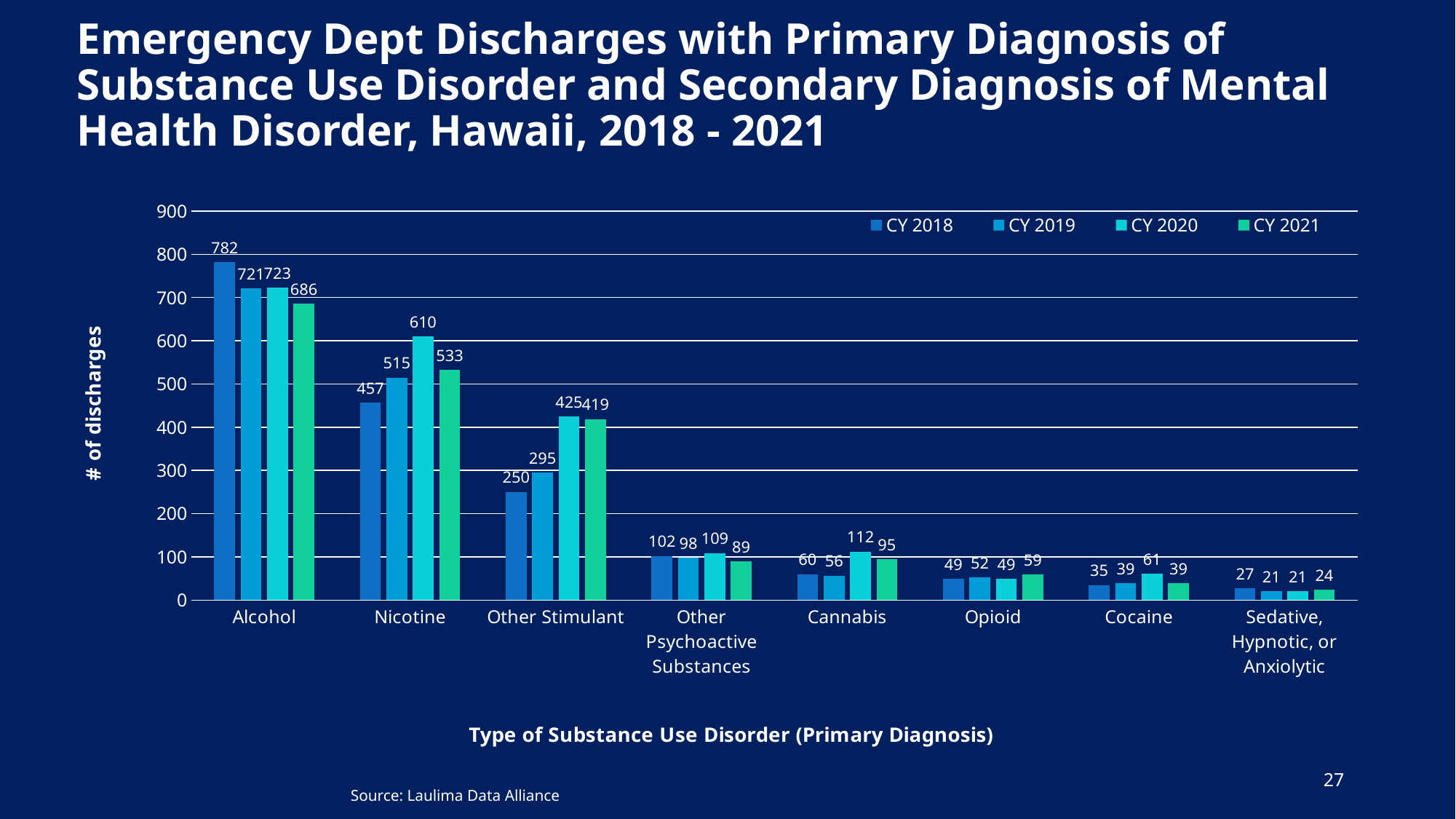
How many series does the legend list? 4 What kind of chart is shown on the slide? Bar chart What is the number of discharges for Cannabis in CY 2019? 56 Which substance use disorder category has the lowest number of discharges in CY 2021? Sedative, Hypnotic, or Anxiolytic What is the label of the y axis? # of discharges How many substance use disorder categories are shown on the x axis? 8 Which is larger for Cocaine: the CY 2020 value or the CY 2021 value? CY 2020 What is the number of discharges for Other Stimulant in CY 2021? 419 What is the number of discharges for Alcohol in CY 2018? 782 Which substance use disorder category has the highest number of discharges in CY 2018? Alcohol What is the difference between the CY 2018 and CY 2021 discharges for Alcohol? 96 What is the number of discharges for Nicotine in CY 2020? 610